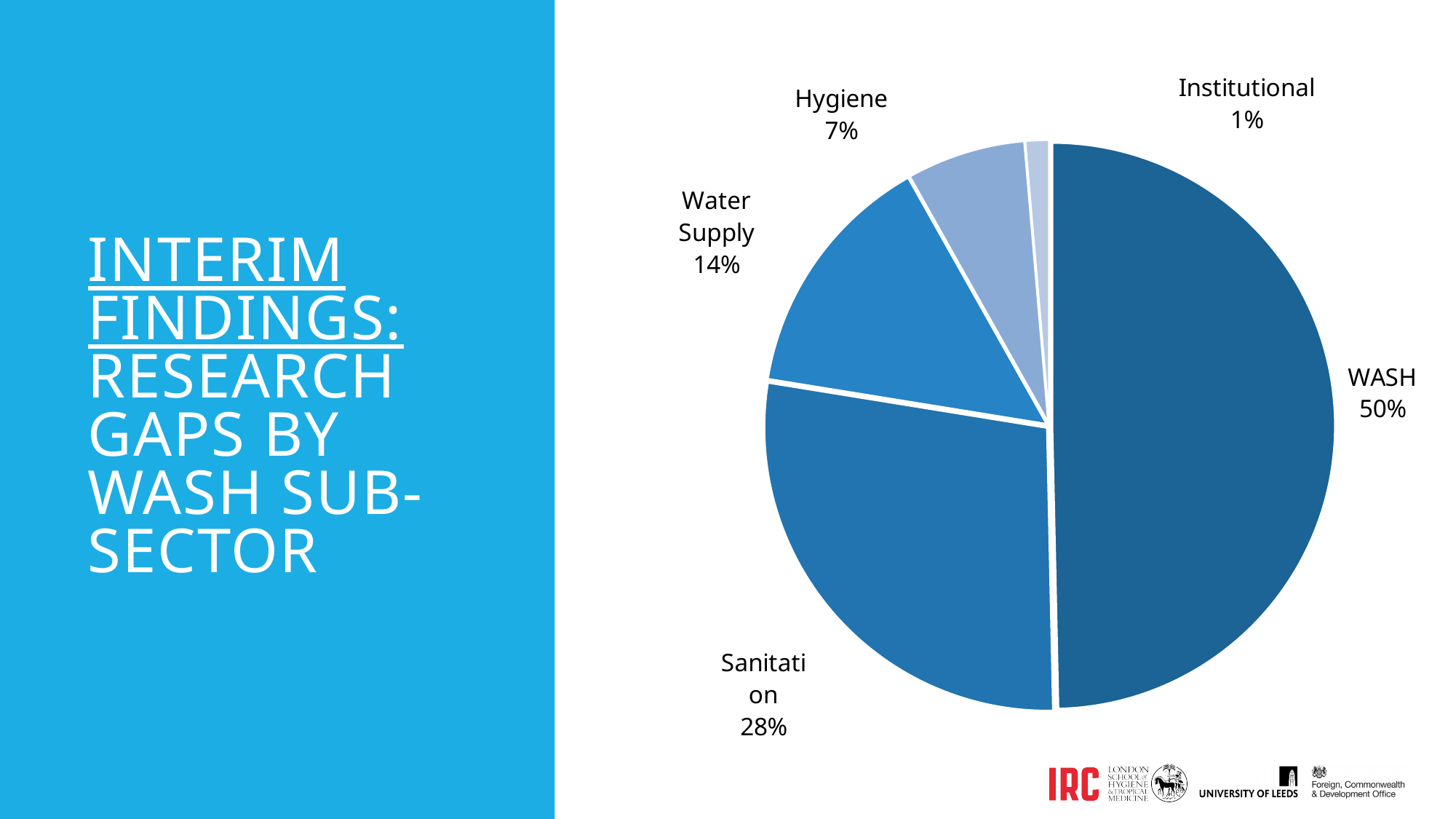
What share of the pie does WASH account for? 50% What is the value for Water Supply? 14% How many categories are shown in the pie chart? 5 Which category has the smallest slice? Institutional Which category has the largest slice? WASH What is the value for Institutional? 1% What is the difference between the WASH and Sanitation shares? 22% What kind of chart is shown on the slide? pie chart What is the title of the slide containing the chart? Interim Findings: Research Gaps by WASH Sub-Sector What is the value for Hygiene? 7% Which is larger, Water Supply or Hygiene? Water Supply What is the value for Sanitation? 28%